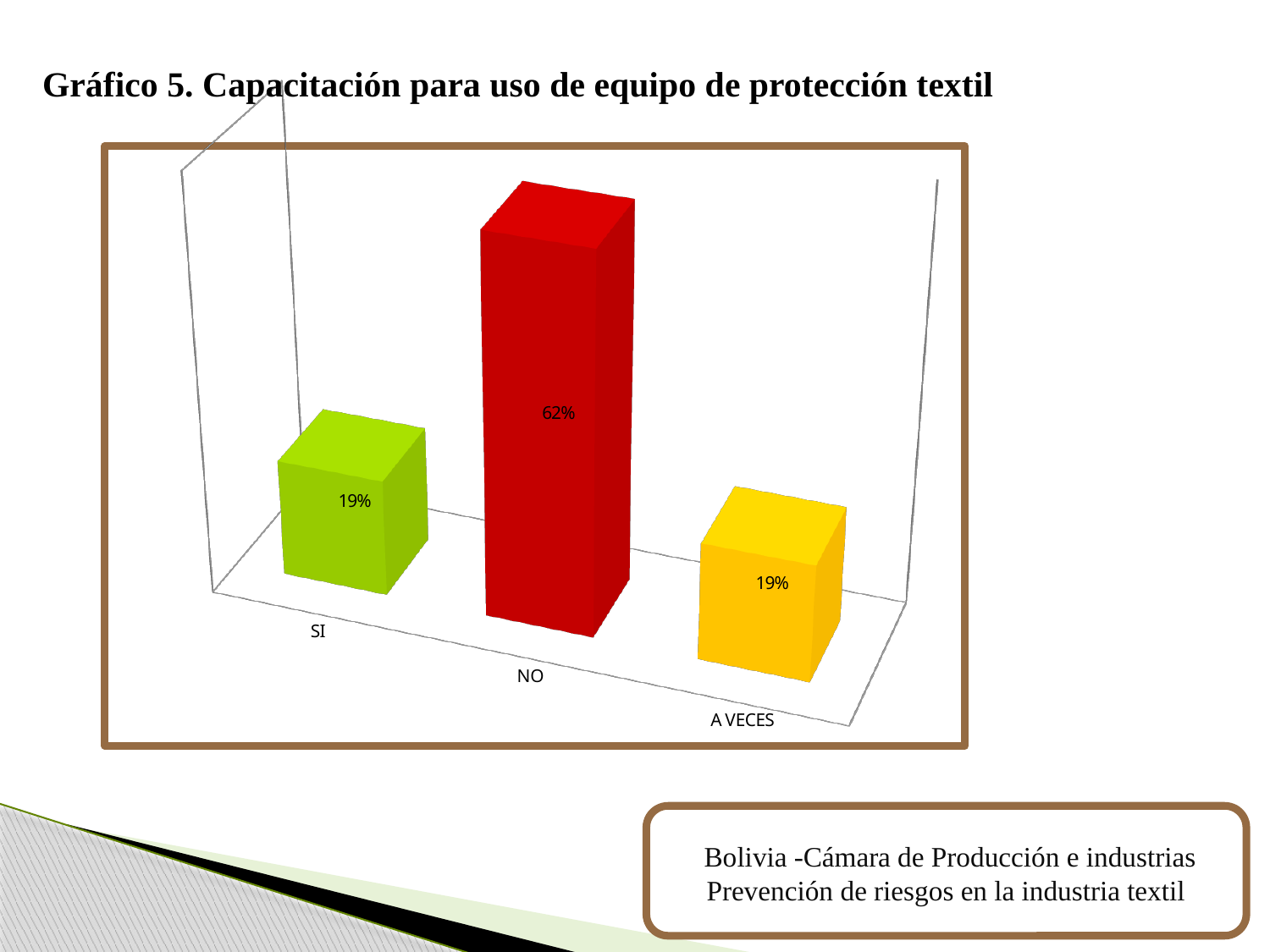
Which category has the highest value? NO How many categories are shown in the chart? 3 What is the title of the chart? Gráfico 5. Capacitación para uso de equipo de protección textil What is the value for A VECES? 19% What is the value for NO? 62% What kind of chart is shown on the slide? Bar chart What colour is the bar for NO? Red What is the difference between the values for NO and A VECES? 43% Which is larger, the value for NO or the value for A VECES? NO What is the total of the three values shown in the chart? 100% What is the value for SI? 19% What is the difference between the values for NO and SI? 43%